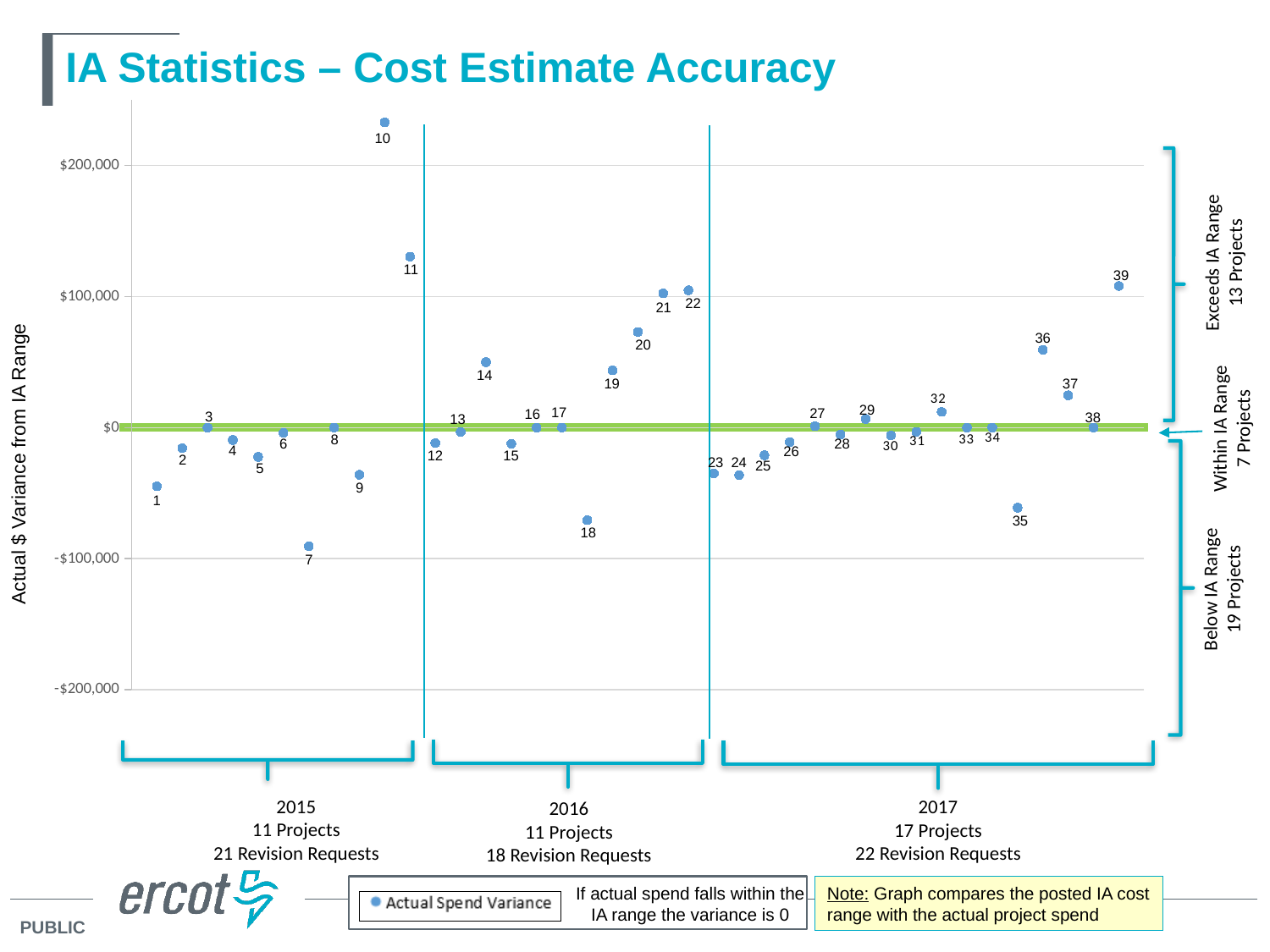
What is the name of the series shown in the legend? Actual Spend Variance How many data points are plotted on the chart? 39 Which has the larger value, point 10 or point 11? 10 Is the value for point 11 greater or less than $100,000? greater What kind of chart is shown on the slide? Scatter chart Is the value for point 10 greater or less than $200,000? greater Which numbered point has the lowest Actual $ Variance from IA Range? 7 Is the value for point 18 greater or less than -$100,000? greater Which has the larger value, point 20 or point 36? 20 How many series does the legend list? 1 Which numbered point has the highest Actual $ Variance from IA Range? 10